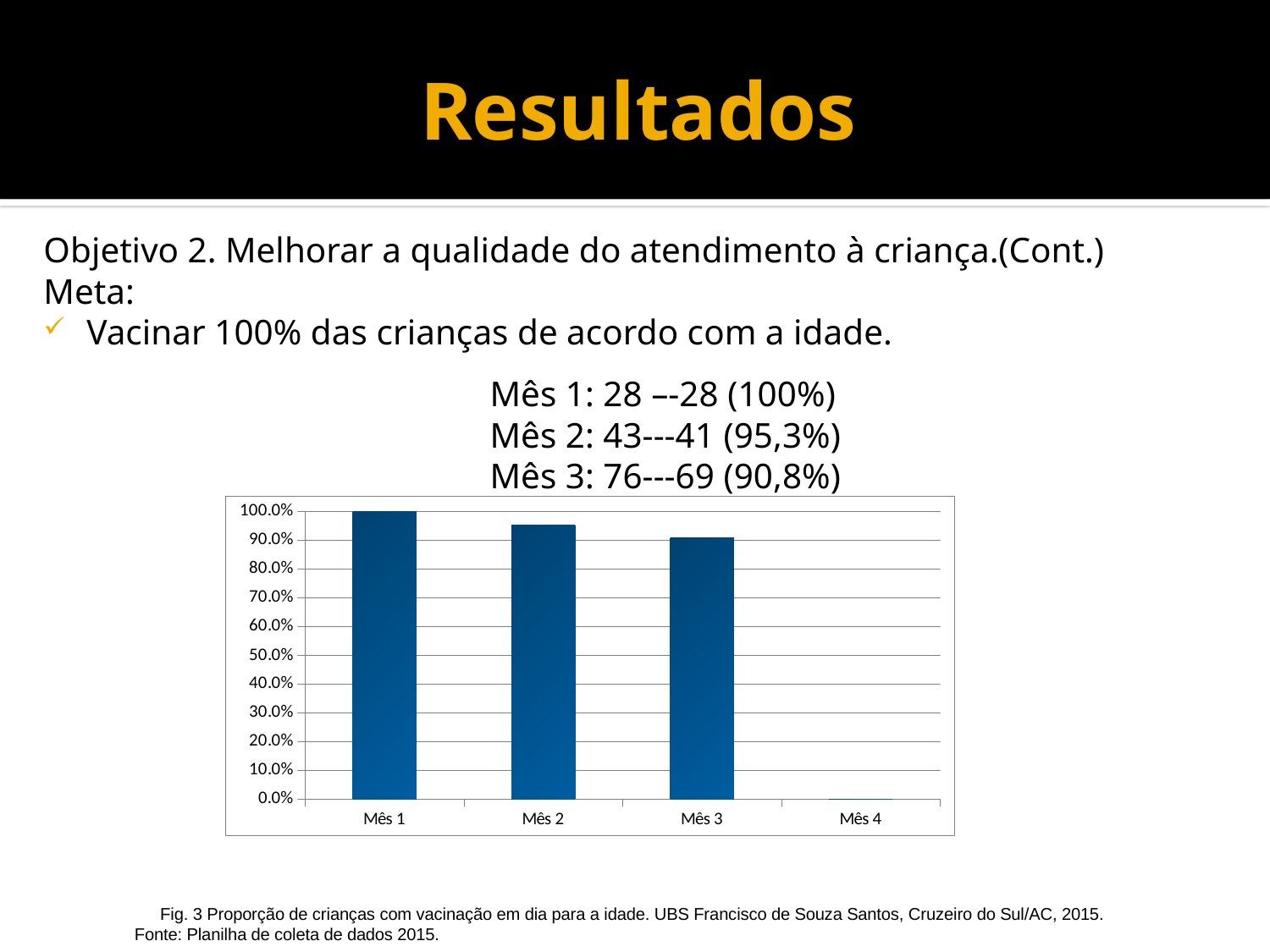
According to the figure caption, what does the chart show the proportion of? crianças com vacinação em dia para a idade Which month has the lowest bar in the chart? Mês 4 Is the value for Mês 2 greater or less than 90.0%? greater How many categories are shown on the x axis of the chart? 4 What kind of chart is shown on the slide? bar chart Is the value for Mês 3 greater or less than 100.0%? less What value does the bar for Mês 1 reach on the y axis? 100.0% What is the highest tick value shown on the y axis of the chart? 100.0% Which month has the highest bar in the chart? Mês 1 Is the value for Mês 4 greater or less than 10.0%? less Do the bar values rise or fall from Mês 1 to Mês 4? fall Which is larger, the value for Mês 2 or the value for Mês 3? Mês 2